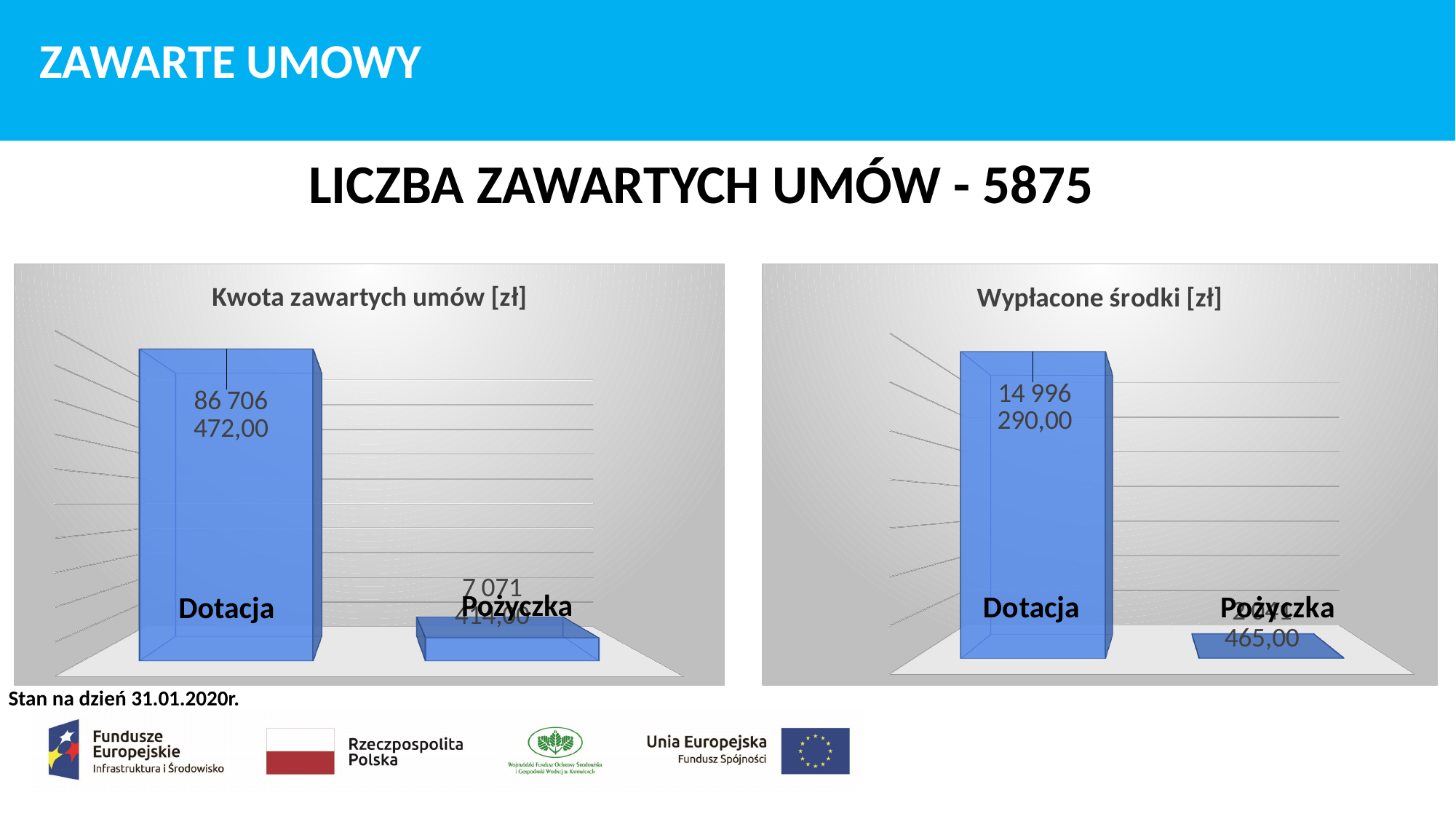
What kind of chart is the chart on the right of the slide, titled "Wypłacone środki [zł]"? Bar chart In the chart titled "Wypłacone środki [zł]", which is larger: Dotacja or Pożyczka? Dotacja What is the title of the chart on the left of the slide? Kwota zawartych umów [zł] How many categories are shown in the chart titled "Kwota zawartych umów [zł]"? 2 In the chart titled "Wypłacone środki [zł]", which category has the lowest value? Pożyczka In the chart titled "Kwota zawartych umów [zł]", which category has the highest value? Dotacja In the chart titled "Wypłacone środki [zł]", which category has the highest value? Dotacja How many categories are shown in the chart titled "Wypłacone środki [zł]"? 2 In the chart titled "Kwota zawartych umów [zł]", what is the value for Dotacja? 86 706 472,00 In the chart titled "Kwota zawartych umów [zł]", which is larger: Dotacja or Pożyczka? Dotacja In the chart titled "Wypłacone środki [zł]", what is the value for Dotacja? 14 996 290,00 In the chart titled "Kwota zawartych umów [zł]", which category has the lowest value? Pożyczka